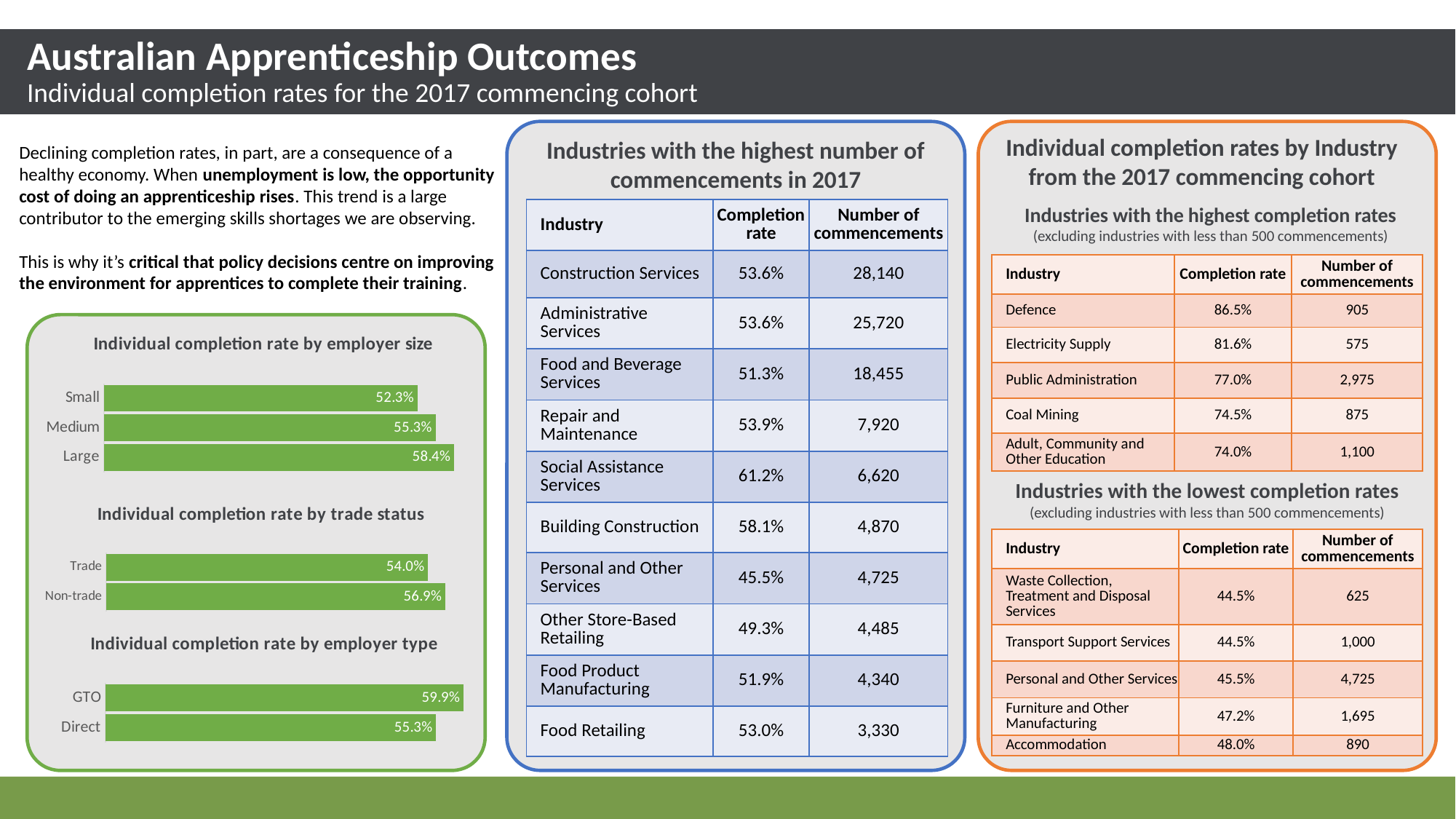
In the 'Individual completion rate by employer size' chart, which employer size has the highest completion rate? Large In the 'Individual completion rate by employer type' chart, which employer type has the higher completion rate? GTO In the 'Individual completion rate by employer size' chart, what is the difference between the completion rates for Large and Small employers? 6.1 percentage points In the 'Individual completion rate by trade status' chart, which is larger, the completion rate for Trade or Non-trade? Non-trade In the 'Individual completion rate by employer size' chart, how many employer size categories are shown? 3 In the 'Individual completion rate by employer type' chart, what is the completion rate for Direct? 55.3% What type of chart is used for 'Individual completion rate by employer size'? Bar chart In the 'Individual completion rate by trade status' chart, what is the difference between the Non-trade and Trade completion rates? 2.9 percentage points In the 'Individual completion rate by trade status' chart, what is the completion rate for Non-trade? 56.9% In the 'Individual completion rate by employer size' chart, which employer size has the lowest completion rate? Small In the 'Individual completion rate by employer type' chart, what is the completion rate for GTO? 59.9% In the 'Individual completion rate by employer size' chart, what is the completion rate for Medium employers? 55.3%